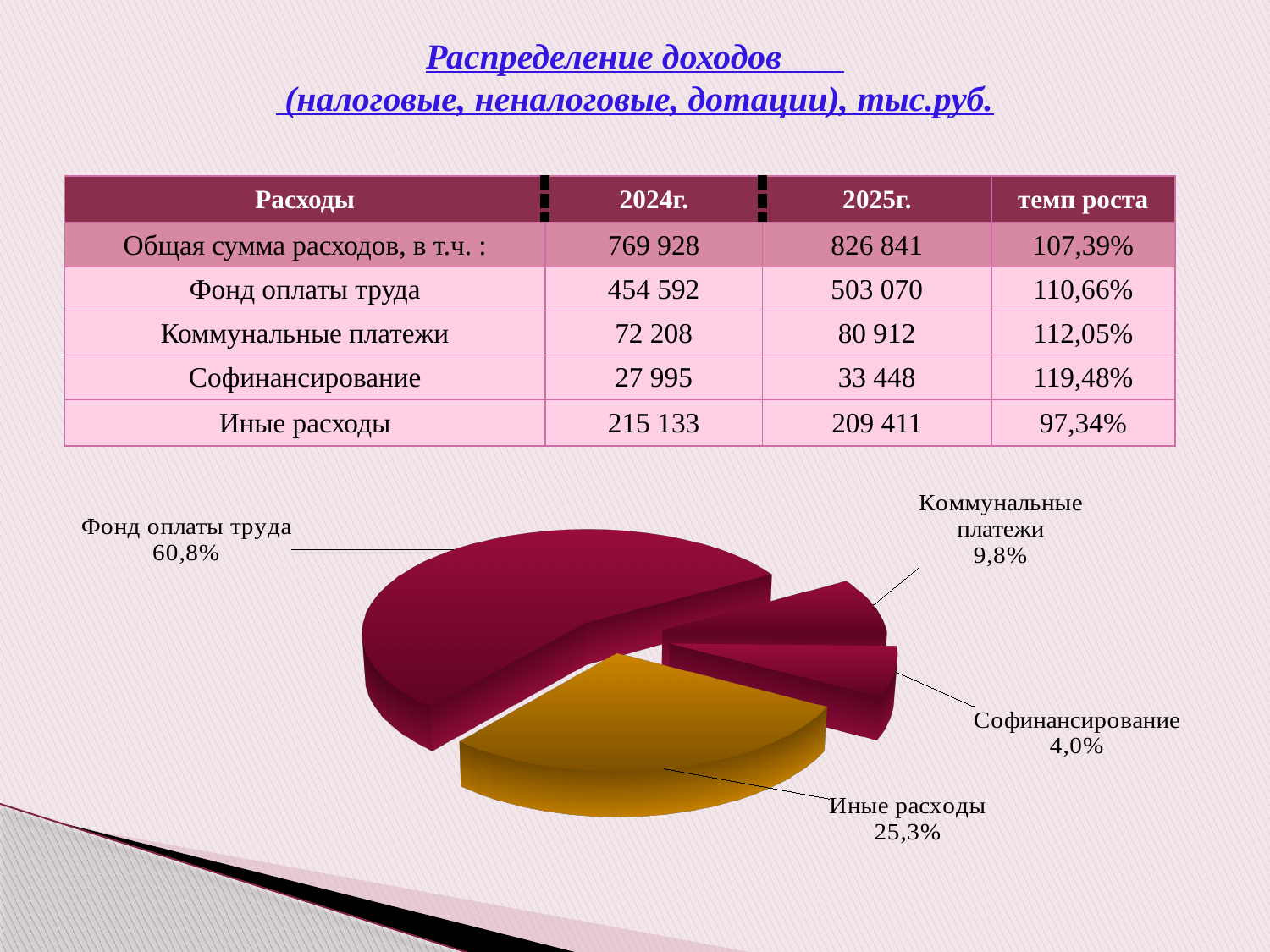
What share of the pie chart does Коммунальные платежи have? 9,8% Which slice of the pie chart is the largest? Фонд оплаты труда What share of the pie chart does Иные расходы have? 25,3% What kind of chart is shown on the slide? pie chart What is the difference in percentage points between the Коммунальные платежи slice and the Софинансирование slice? 5,8 What share of the pie chart does Фонд оплаты труда have? 60,8% Which slice of the pie chart is the smallest? Софинансирование What is the difference in percentage points between the Фонд оплаты труда slice and the Иные расходы slice? 35,5 Which is larger in the pie chart: Иные расходы or Коммунальные платежи? Иные расходы Which slice of the pie chart is coloured gold/orange rather than crimson? Иные расходы How many slices does the pie chart have? 4